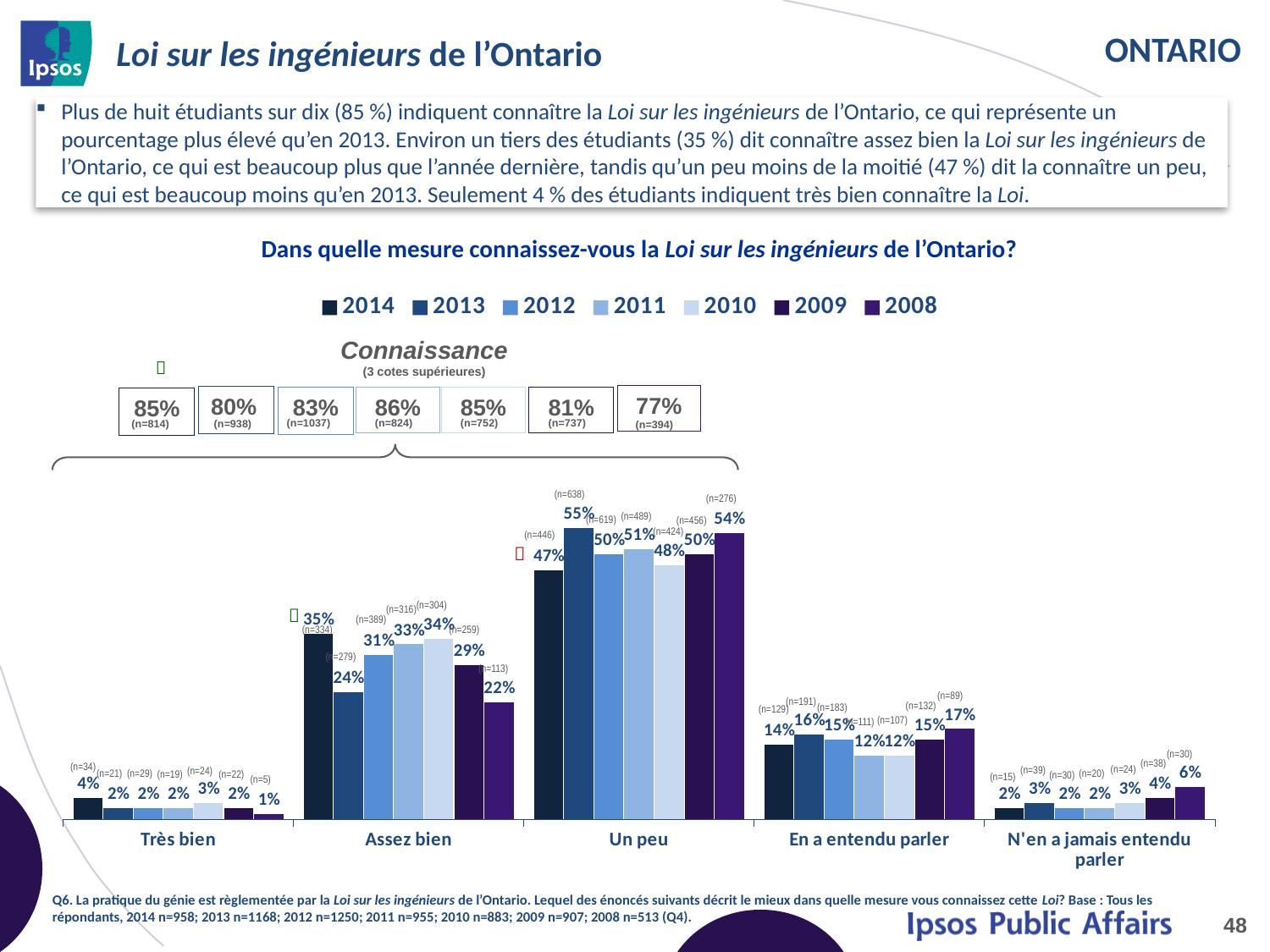
Which year has the highest value in the "Un peu" category? 2013 Which is larger in the "Un peu" category: the value for 2014 or the value for 2008? 2008 What is the difference between the 2014 and 2013 values in the "Assez bien" category? 11% Which year has the lowest value in the "Assez bien" category? 2008 What is the value for 2014 in the "Très bien" category? 4% What is the value for 2008 in the "N'en a jamais entendu parler" category? 6% What is the value for 2011 in the "En a entendu parler" category? 12% What is the value for 2013 in the "Un peu" category? 55% What kind of chart is shown on the slide? Bar chart What is the value for 2014 in the "Assez bien" category? 35% How many series does the legend list? 7 How many response categories are shown on the x axis? 5